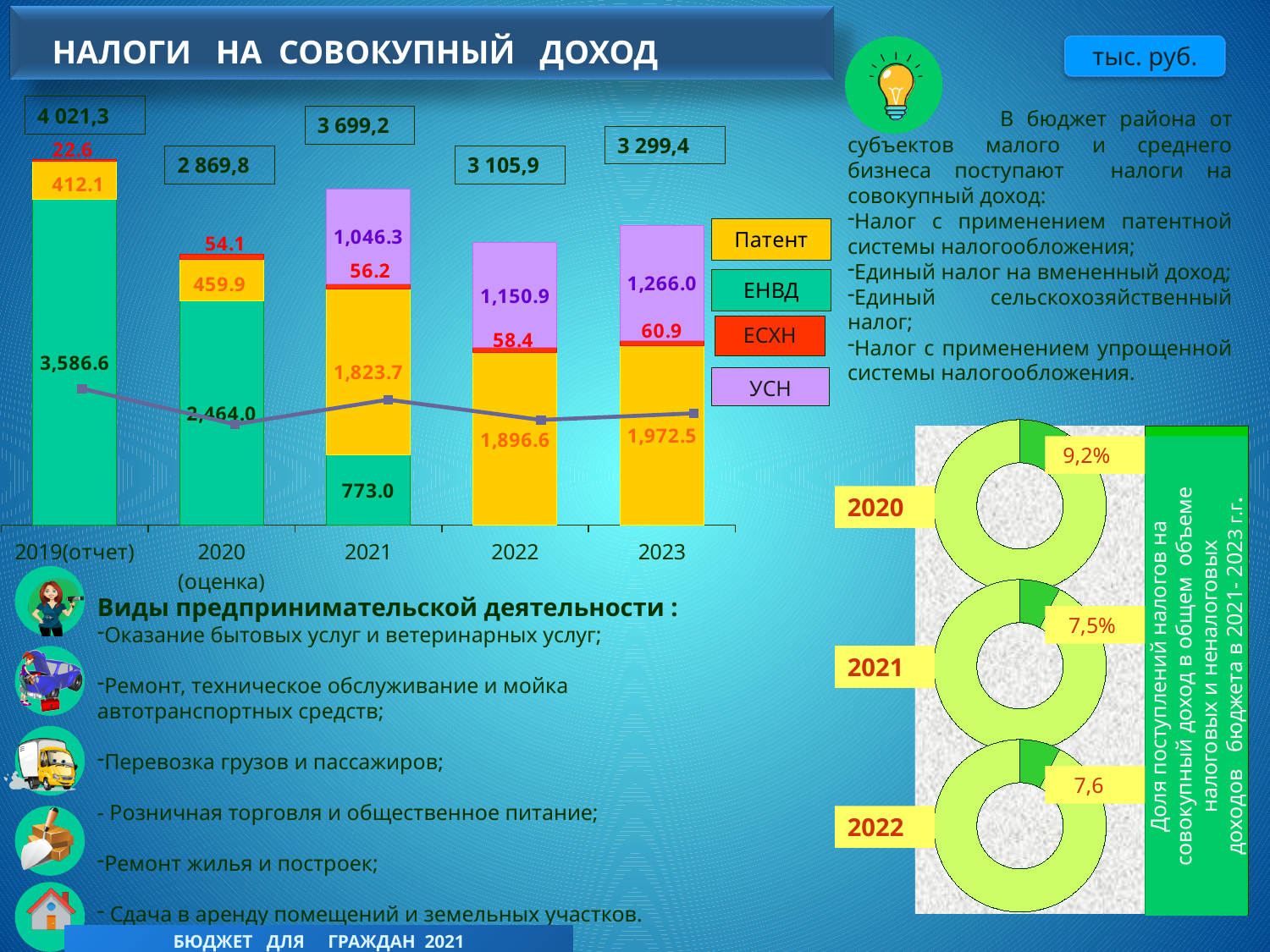
In the stacked bar chart, what is the difference between the Патент values for 2023 and 2022? 75.9 How many years are shown on the x axis of the stacked bar chart? 5 In the stacked bar chart, which year has the lowest total? 2020 In the stacked bar chart, what is the total shown above the bar for 2020? 2 869,8 In the stacked bar chart, which year has the highest total? 2019(отчет) In the donut charts on the right, what share is shown for 2020? 9,2% In the stacked bar chart, what is the ЕНВД value for 2019(отчет)? 3,586.6 How many series does the legend of the stacked bar chart list? 4 In the stacked bar chart, which is larger: the УСН value for 2021 or the УСН value for 2022? 2022 In the stacked bar chart, what is the ЕСХН value for 2022? 58.4 In the stacked bar chart, what is the Патент value for 2021? 1,823.7 In the stacked bar chart, what is the УСН value for 2023? 1,266.0